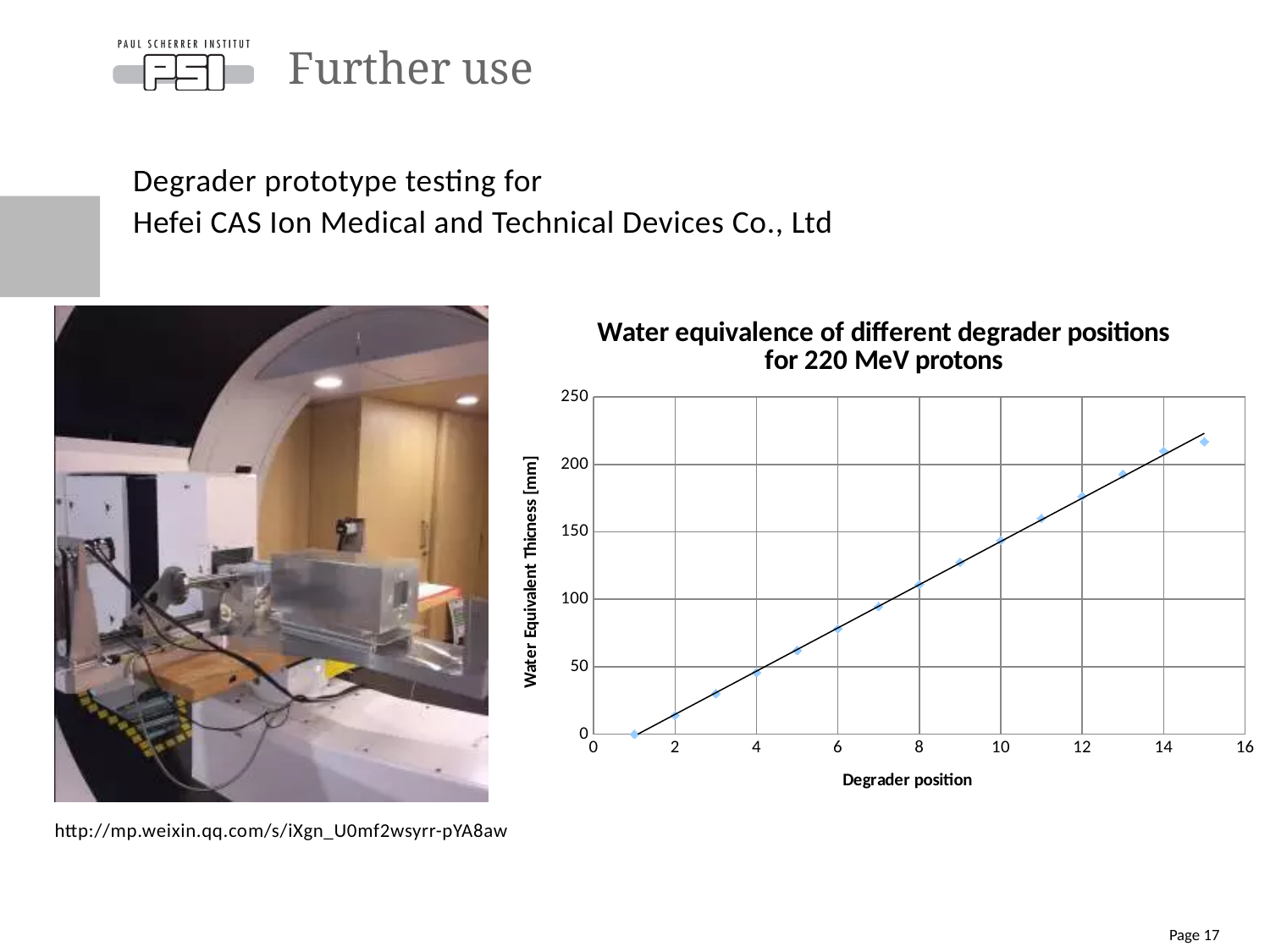
Is the water equivalent thickness at degrader position 14 greater or less than 200? greater Does the water equivalent thickness rise or fall as the degrader position increases? rise Is the water equivalent thickness at degrader position 12 greater or less than 200? less Is the water equivalent thickness at degrader position 3 greater or less than 50? less What is the title of the chart? Water equivalence of different degrader positions for 220 MeV protons Which degrader position has the lowest water equivalent thickness? 1 Which degrader position has the highest water equivalent thickness? 15 What kind of chart is shown on the slide? scatter chart Which has a larger water equivalent thickness, degrader position 6 or degrader position 11? 11 How many data points are plotted in the chart? 15 What is the label of the y axis of the chart? Water Equivalent Thicness [mm]